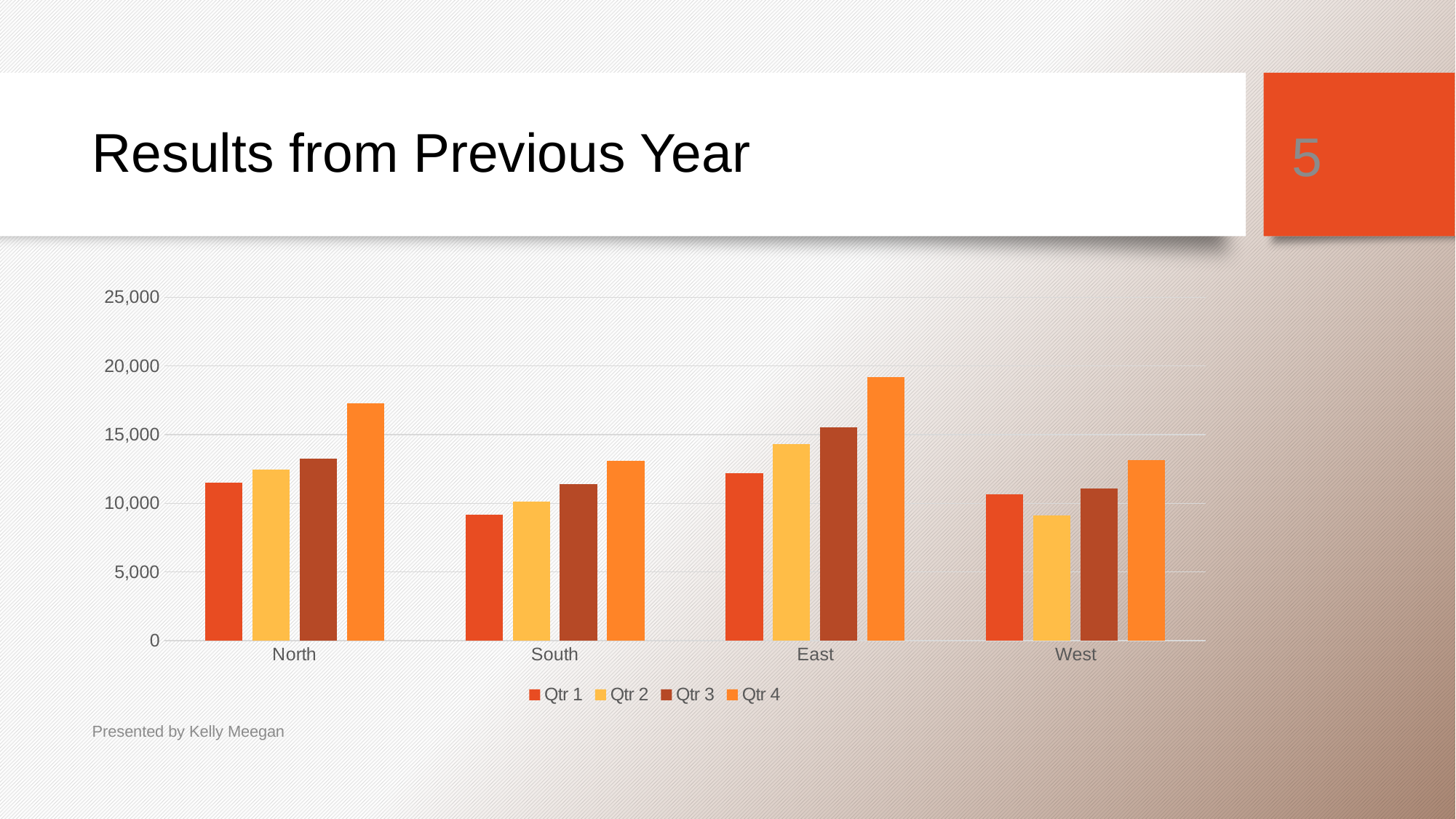
Which is larger, the Qtr 3 value for East or the Qtr 3 value for North? East For East, do the values rise or fall from Qtr 1 to Qtr 4? rise What kind of chart is shown on the slide? bar chart Is the Qtr 4 value for North greater or less than 15,000? greater How many regions are shown on the x axis of the chart? 4 For West, which is larger, the Qtr 1 value or the Qtr 2 value? Qtr 1 Which region has the lowest Qtr 1 value? South Is the Qtr 4 value for East greater or less than 20,000? less Is the Qtr 1 value for South greater or less than 10,000? less How many series does the chart's legend list? 4 Which region has the highest Qtr 4 value? East What are the entries listed in the chart's legend? Qtr 1, Qtr 2, Qtr 3, Qtr 4